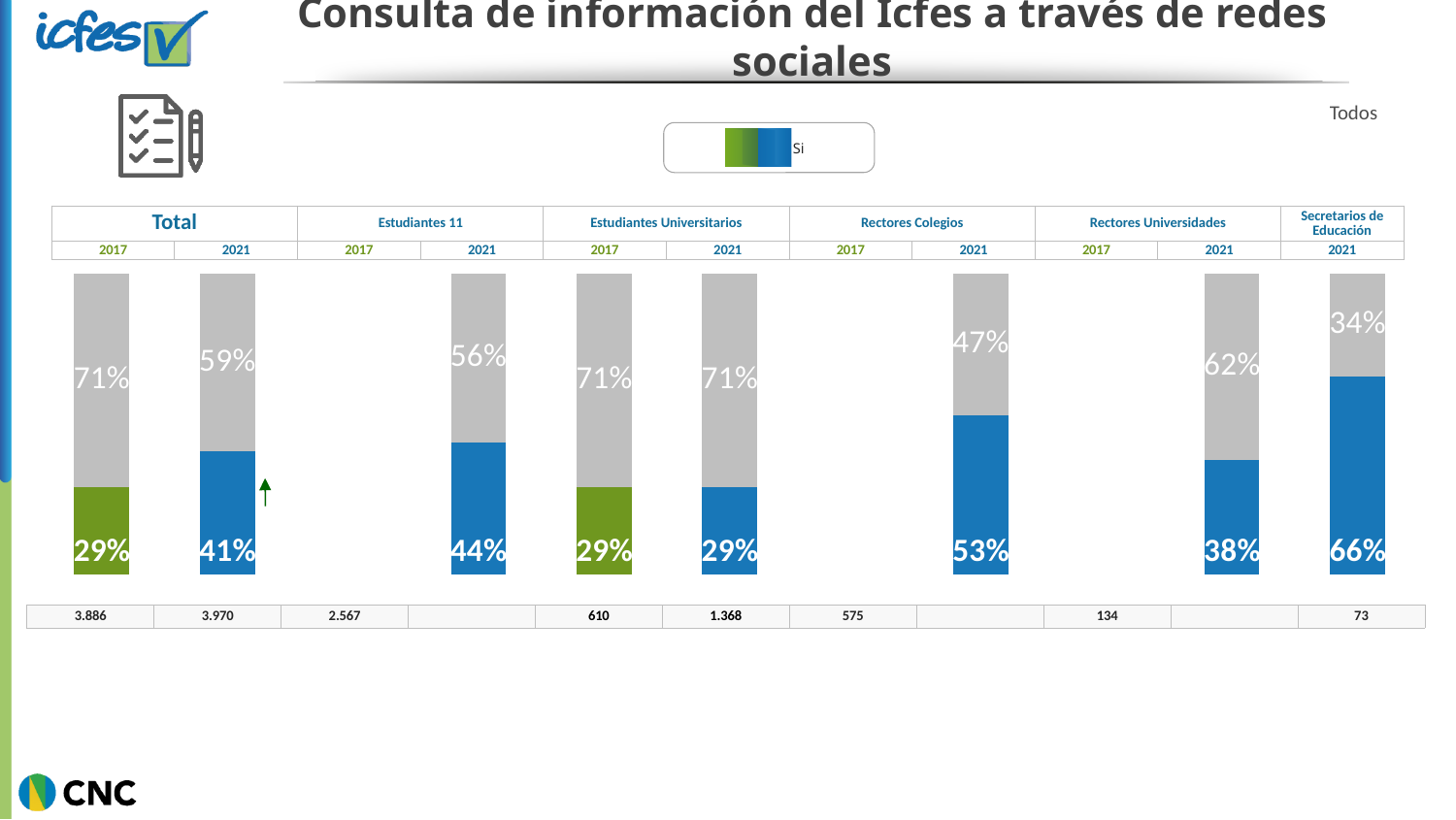
What is the sample size shown for Secretarios de Educación in 2021? 73 By how many percentage points did the Total 'Si' share change from 2017 to 2021? 12 percentage points What is the 'Si' percentage for Secretarios de Educación in 2021? 66% Which group has the lowest 'Si' percentage in 2021? Estudiantes Universitarios Did the 'Si' percentage for Estudiantes Universitarios rise, fall or stay the same from 2017 to 2021? Stayed the same Which group has the highest 'Si' percentage in 2021? Secretarios de Educación What percentage of the Total group answered 'Si' in 2021? 41% Which is larger in 2021: the 'Si' percentage for Rectores Colegios or for Rectores Universidades? Rectores Colegios What is the sample size shown for Estudiantes Universitarios in 2021? 1.368 What is the 'Si' percentage for Estudiantes 11 in 2021? 44% What type of chart is shown on the slide? Stacked bar chart What percentage of the Total group answered 'Si' in 2017? 29%